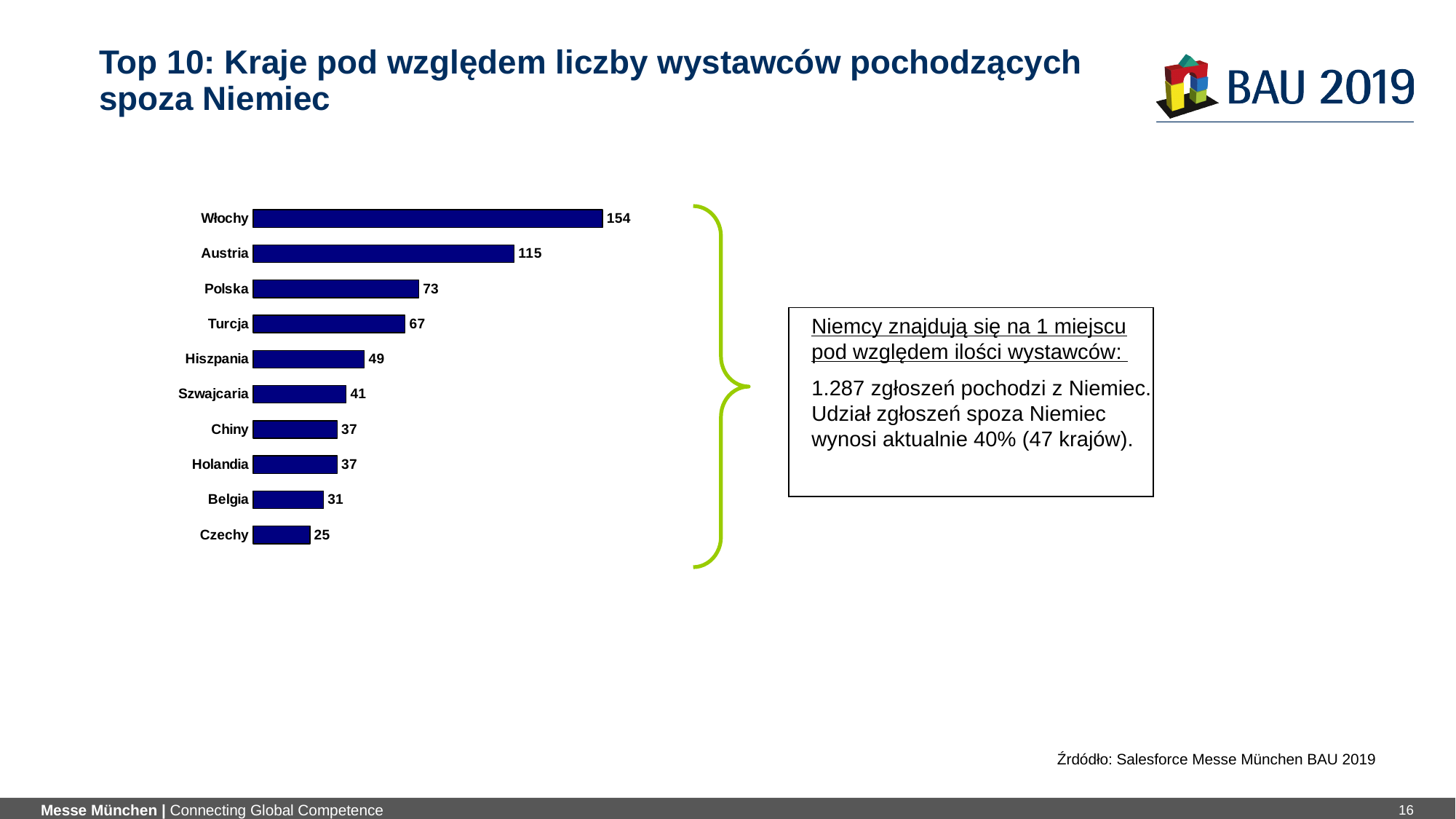
What is the difference between the values for Włochy and Austria? 39 What kind of chart is shown on the slide? Bar chart Which country has the lowest value? Czechy How many countries are shown in the chart? 10 What is the value for Hiszpania? 49 What is the difference between the values for Polska and Turcja? 6 What is the value for Czechy? 25 What is the value for Austria? 115 Which has a larger value, Szwajcaria or Belgia? Szwajcaria Which two countries share the same value of 37? Chiny and Holandia What is the value for Włochy? 154 Which country has the highest value? Włochy